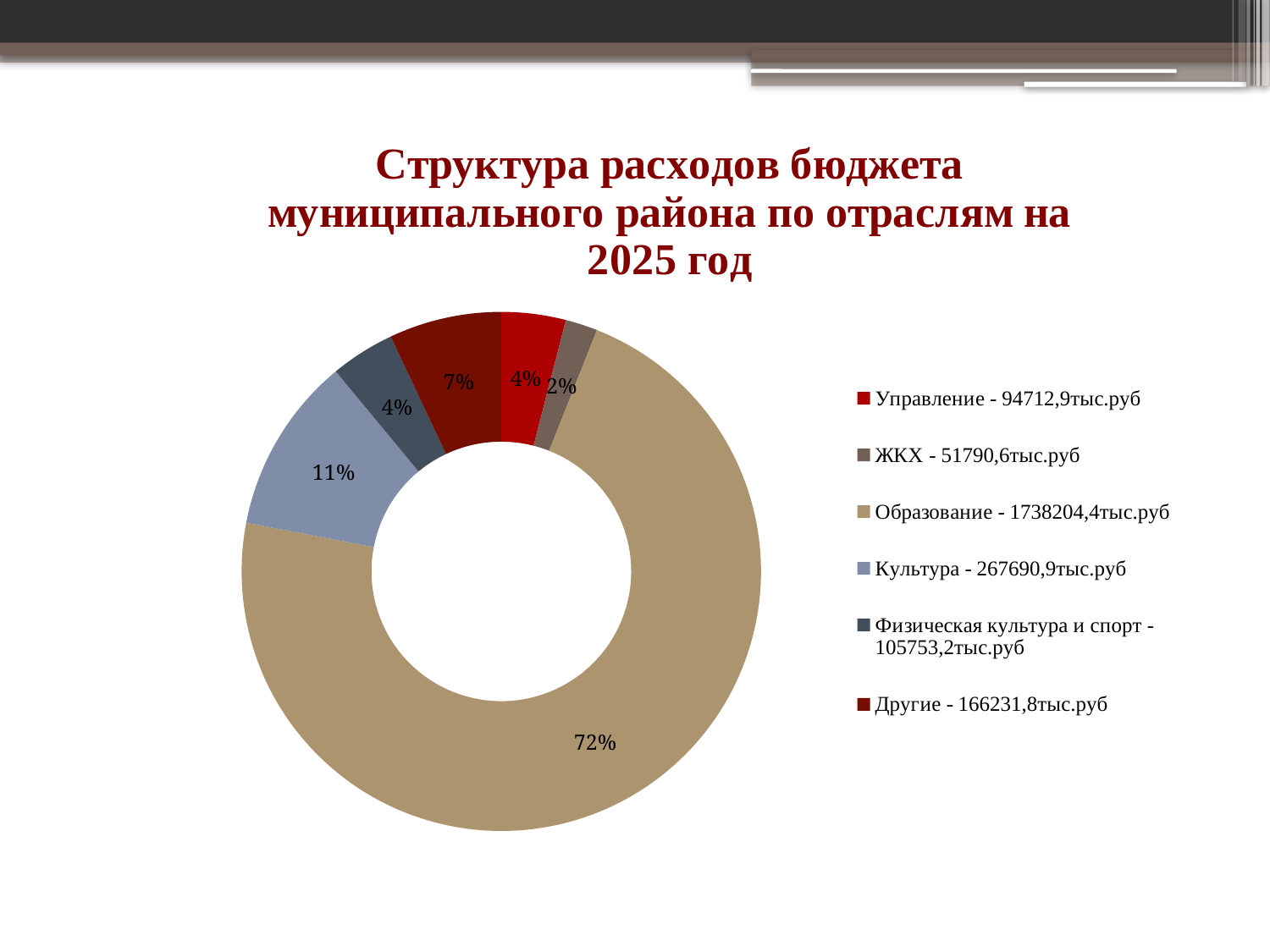
What share of the chart does Другие take? 7% What share of the chart does Культура take? 11% How many categories are shown in the chart? 6 According to the legend, what is the amount for Управление? 94712,9тыс.руб What kind of chart is shown on the slide? doughnut (pie) chart According to the legend, what is the amount for Физическая культура и спорт? 105753,2тыс.руб Which category has the smallest slice? ЖКХ Which slice is larger, Культура or Другие? Культура Which category has the largest slice? Образование What share of the chart does ЖКХ take? 2% By how many percentage points does the Образование share exceed the Культура share? 61 percentage points